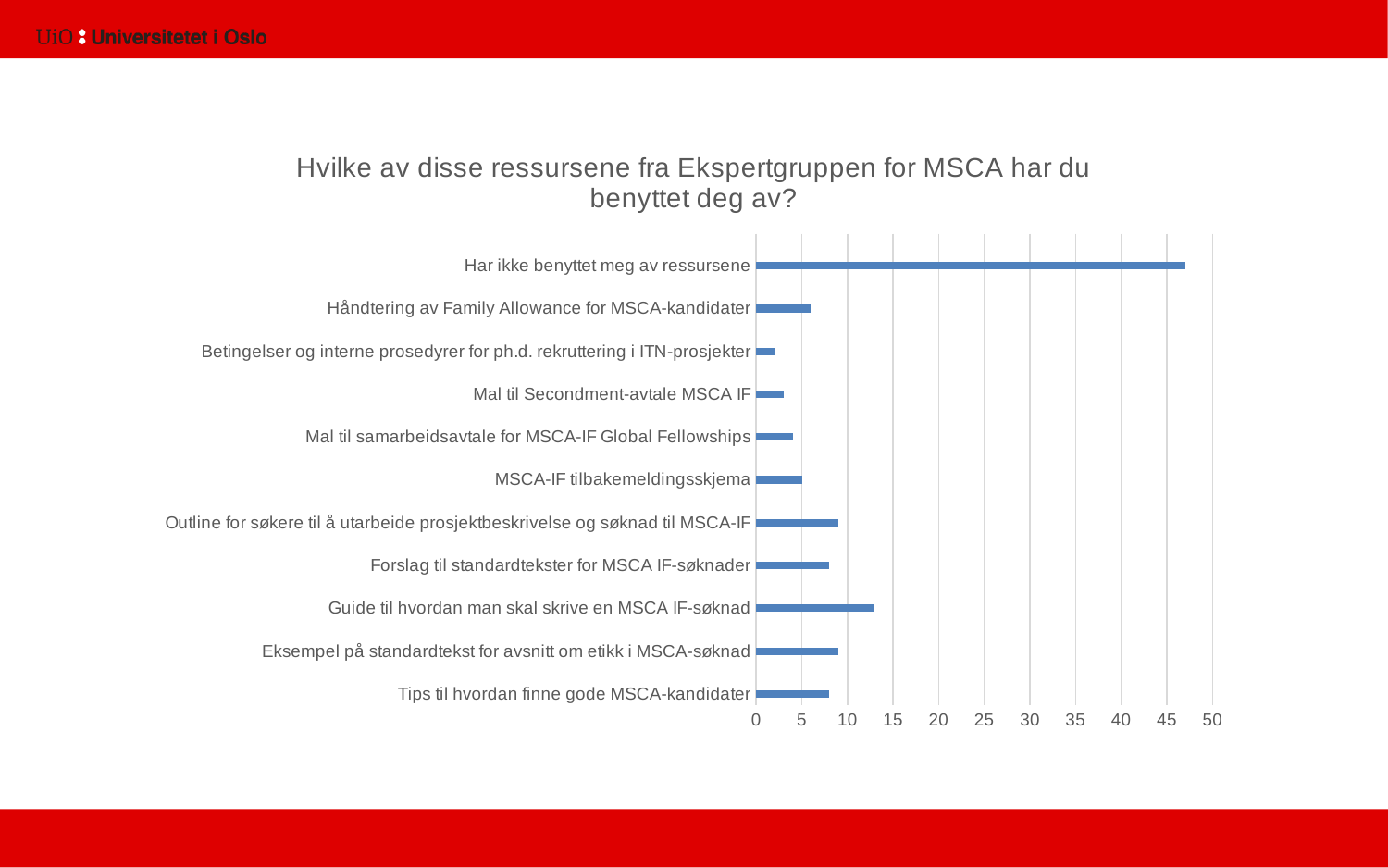
What kind of chart is shown on the slide? Bar chart Which category has the highest value in the chart? Har ikke benyttet meg av ressursene Is the value for "Betingelser og interne prosedyrer for ph.d. rekruttering i ITN-prosjekter" greater or less than 5? less Is the value for "Guide til hvordan man skal skrive en MSCA IF-søknad" greater or less than 15? less Which has the larger value: "Outline for søkere til å utarbeide prosjektbeskrivelse og søknad til MSCA-IF" or "Betingelser og interne prosedyrer for ph.d. rekruttering i ITN-prosjekter"? Outline for søkere til å utarbeide prosjektbeskrivelse og søknad til MSCA-IF Is the value for "Outline for søkere til å utarbeide prosjektbeskrivelse og søknad til MSCA-IF" greater or less than 10? less Which has the larger value: "Guide til hvordan man skal skrive en MSCA IF-søknad" or "Forslag til standardtekster for MSCA IF-søknader"? Guide til hvordan man skal skrive en MSCA IF-søknad What is the title of the chart? Hvilke av disse ressursene fra Ekspertgruppen for MSCA har du benyttet deg av? How many categories are plotted in the chart? 11